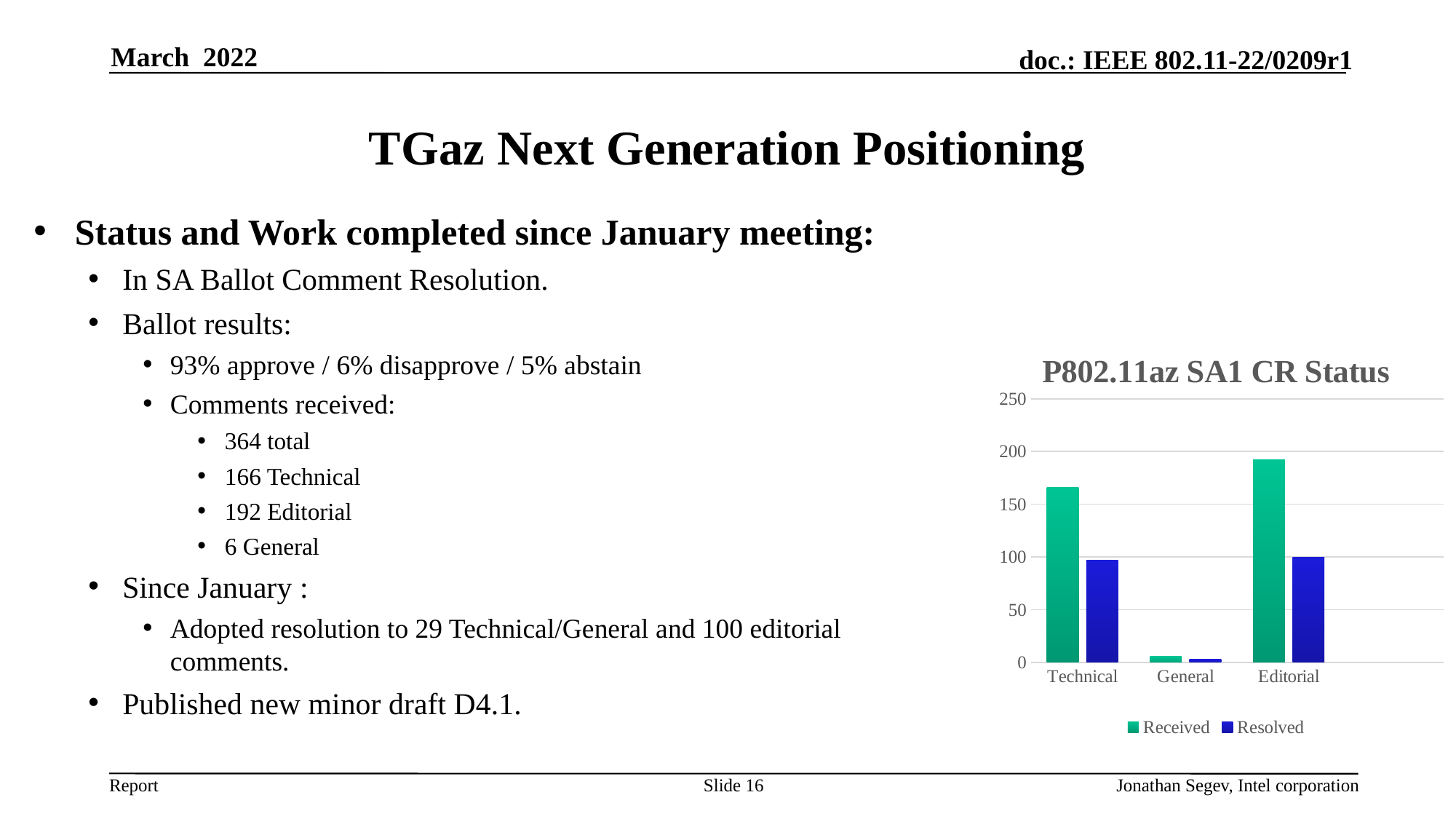
Is the Received value for Technical greater or less than 150? greater What is the title of the chart? P802.11az SA1 CR Status Which category has the lowest Resolved value? General How many categories are shown on the x axis of the chart? 3 Is the Received value for Editorial greater or less than 200? less Which series is shown in blue in the chart? Resolved Which category has the highest Received value? Editorial For Technical, which is larger: Received or Resolved? Received What kind of chart is shown on the slide? bar chart Which category has the lowest Received value? General How many series does the chart legend list? 2